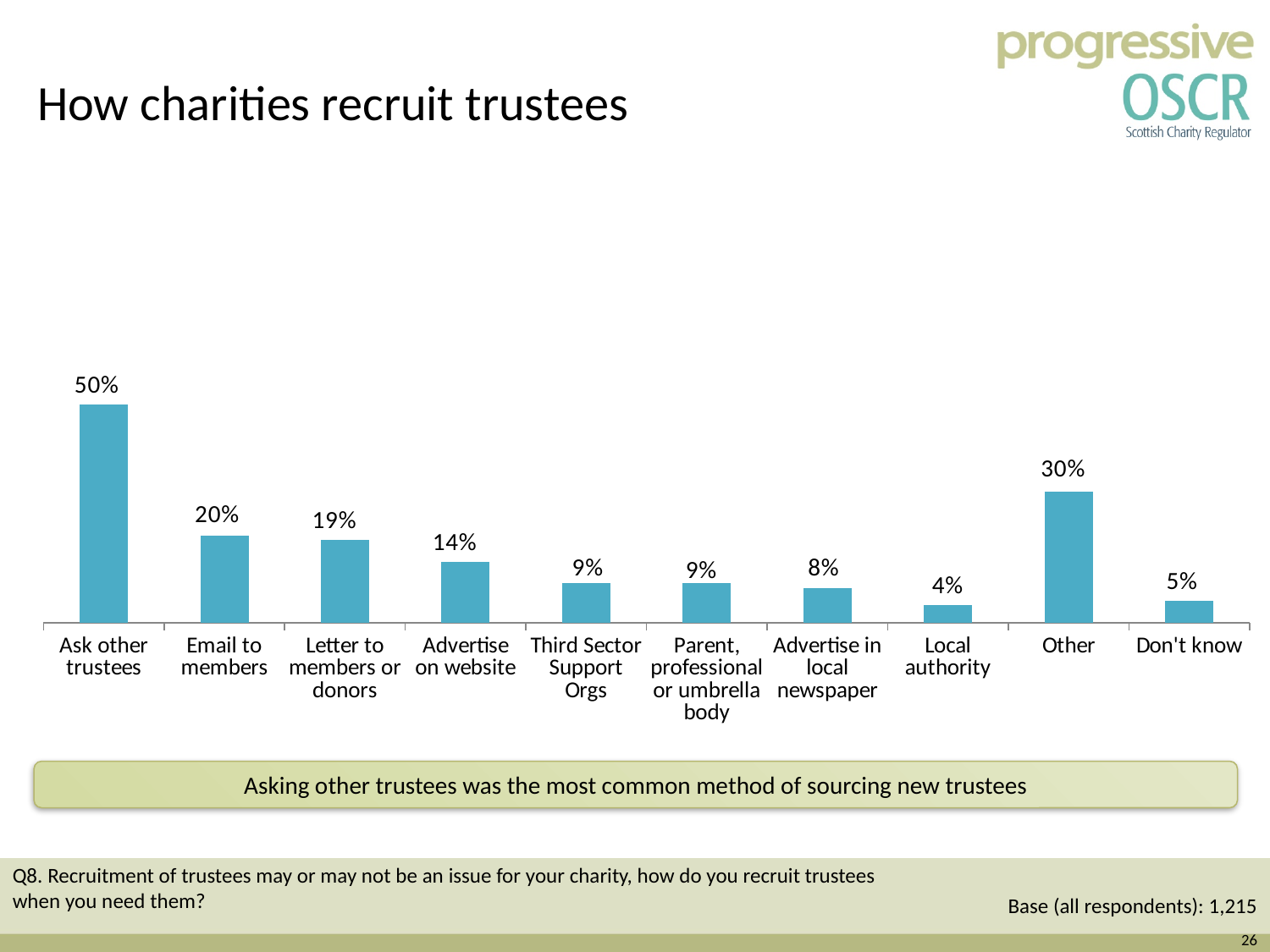
Which is larger, 'Advertise in local newspaper' or 'Don't know'? Advertise in local newspaper Which recruitment method has the highest value? Ask other trustees What is the difference between 'Email to members' and 'Letter to members or donors'? 1% How many categories are shown on the chart? 10 What is the title of the slide? How charities recruit trustees What is the value for 'Local authority'? 4% What is the value for 'Advertise on website'? 14% What percentage of charities recruit trustees by asking other trustees? 50% Which category has the lowest value? Local authority What is the difference between 'Ask other trustees' and 'Other'? 20% What is the value for 'Other'? 30% What kind of chart is shown on the slide? Bar chart